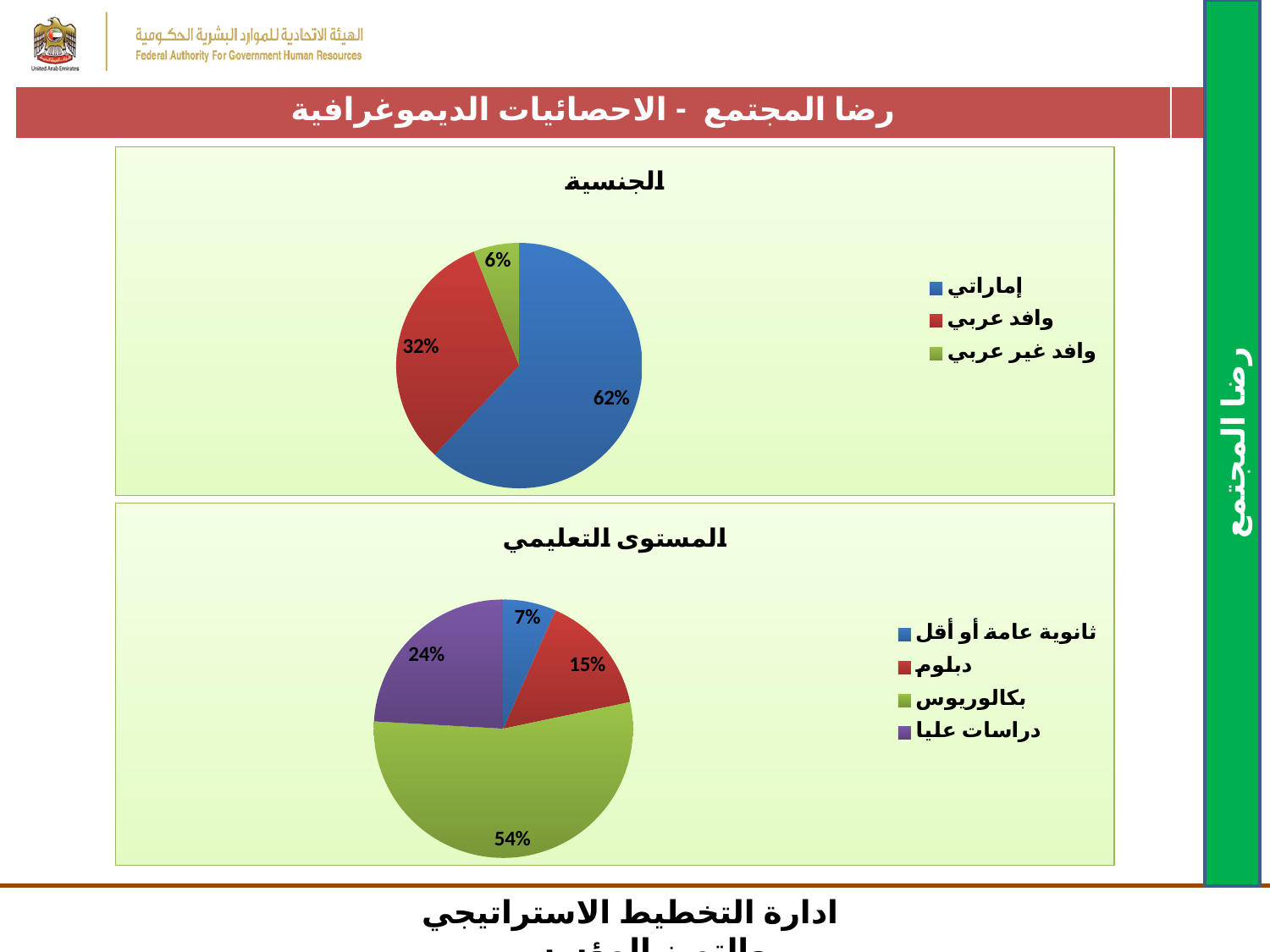
In the "المستوى التعليمي" chart, what share is labelled for دراسات عليا? 24% In the "المستوى التعليمي" chart, what share is labelled for بكالوريوس? 54% In the "الجنسية" chart, what is the difference in percentage points between إماراتي and وافد عربي? 30 In the "المستوى التعليمي" chart, what is the difference in percentage points between بكالوريوس and دراسات عليا? 30 In the "المستوى التعليمي" chart, which category has the largest slice? بكالوريوس In the "الجنسية" chart, what share is labelled for وافد عربي? 32% In the "المستوى التعليمي" chart, which is larger, دبلوم or ثانوية عامة أو أقل? دبلوم What type of chart is the "المستوى التعليمي" chart? Pie chart How many entries does the legend of the "المستوى التعليمي" chart list? 4 In the "الجنسية" chart, what share is labelled for إماراتي? 62% In the "الجنسية" chart, which category has the smallest slice? وافد غير عربي How many slices does the "الجنسية" pie chart have? 3